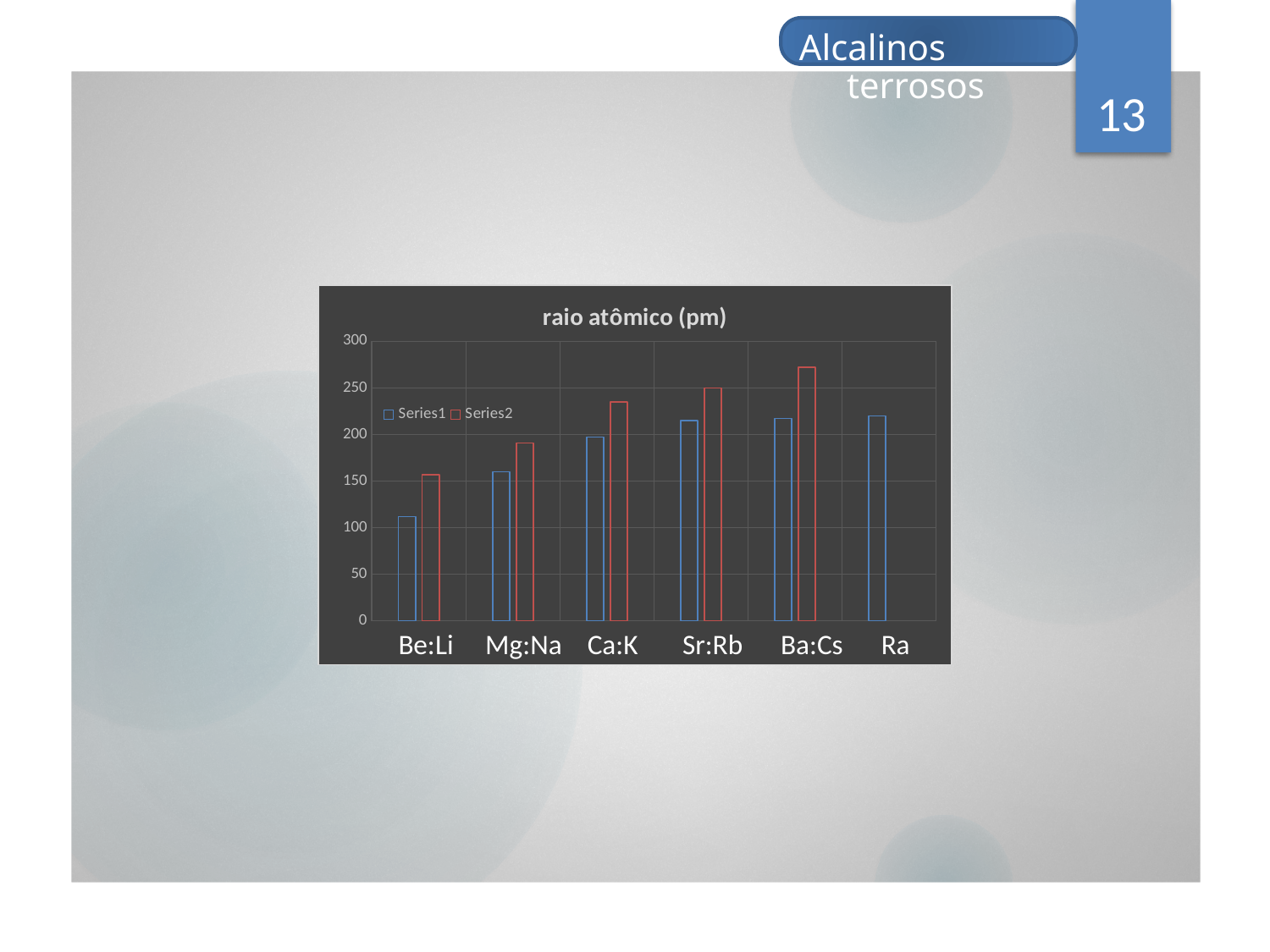
Is the Series2 value for Ca:K greater or less than 200? greater Which category has the highest Series2 value? Ba:Cs Which category has the lowest Series1 value? Be:Li What kind of chart is shown on the slide? bar chart Do the Series1 values rise or fall from Be:Li to Ra along the x axis? rise For Ca:K, which is larger, the Series1 value or the Series2 value? Series2 Is the Series2 value for Ba:Cs greater or less than 250? greater Which category has the lowest Series2 value? Be:Li How many series does the legend list? 2 Is the Series1 value for Be:Li greater or less than 150? less What is the title of the chart? raio atômico (pm) How many categories are shown on the x axis? 6